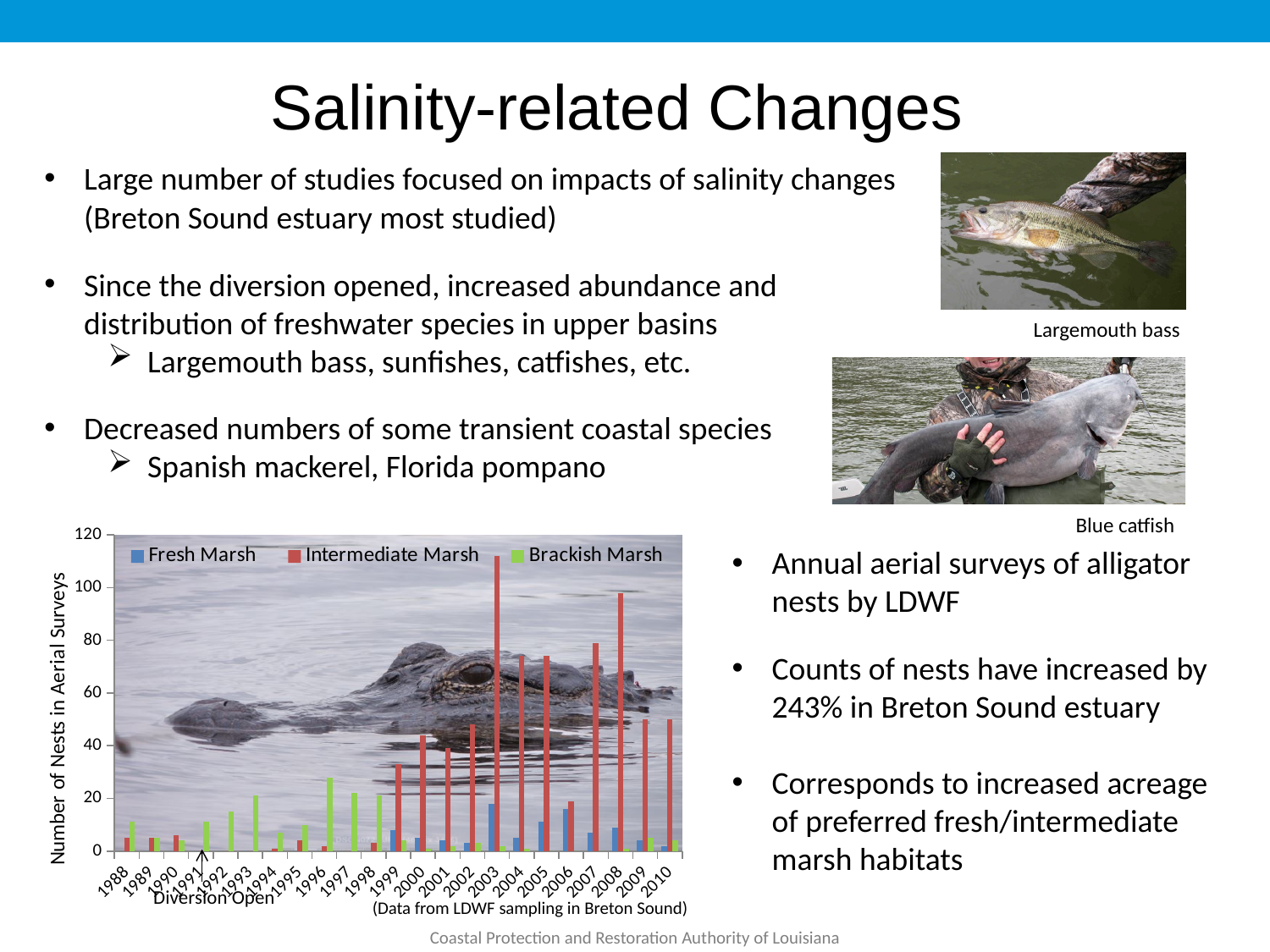
In which year is the Intermediate Marsh bar highest? 2003 How many series does the chart legend list? 3 How many years are shown along the x axis of the chart? 23 Is the Intermediate Marsh value for 2008 greater or less than 80? greater Is the Intermediate Marsh value for 2003 greater or less than 100? greater Which is larger, the Intermediate Marsh value for 2003 or for 2008? 2003 Is the Fresh Marsh value for 2005 greater or less than 20? less What kind of chart is shown on the slide? bar chart Which series are listed in the chart legend? Fresh Marsh, Intermediate Marsh, Brackish Marsh What is the y-axis title of the chart? Number of Nests in Aerial Surveys Do the Intermediate Marsh values generally rise or fall from 1988 to 2010? rise